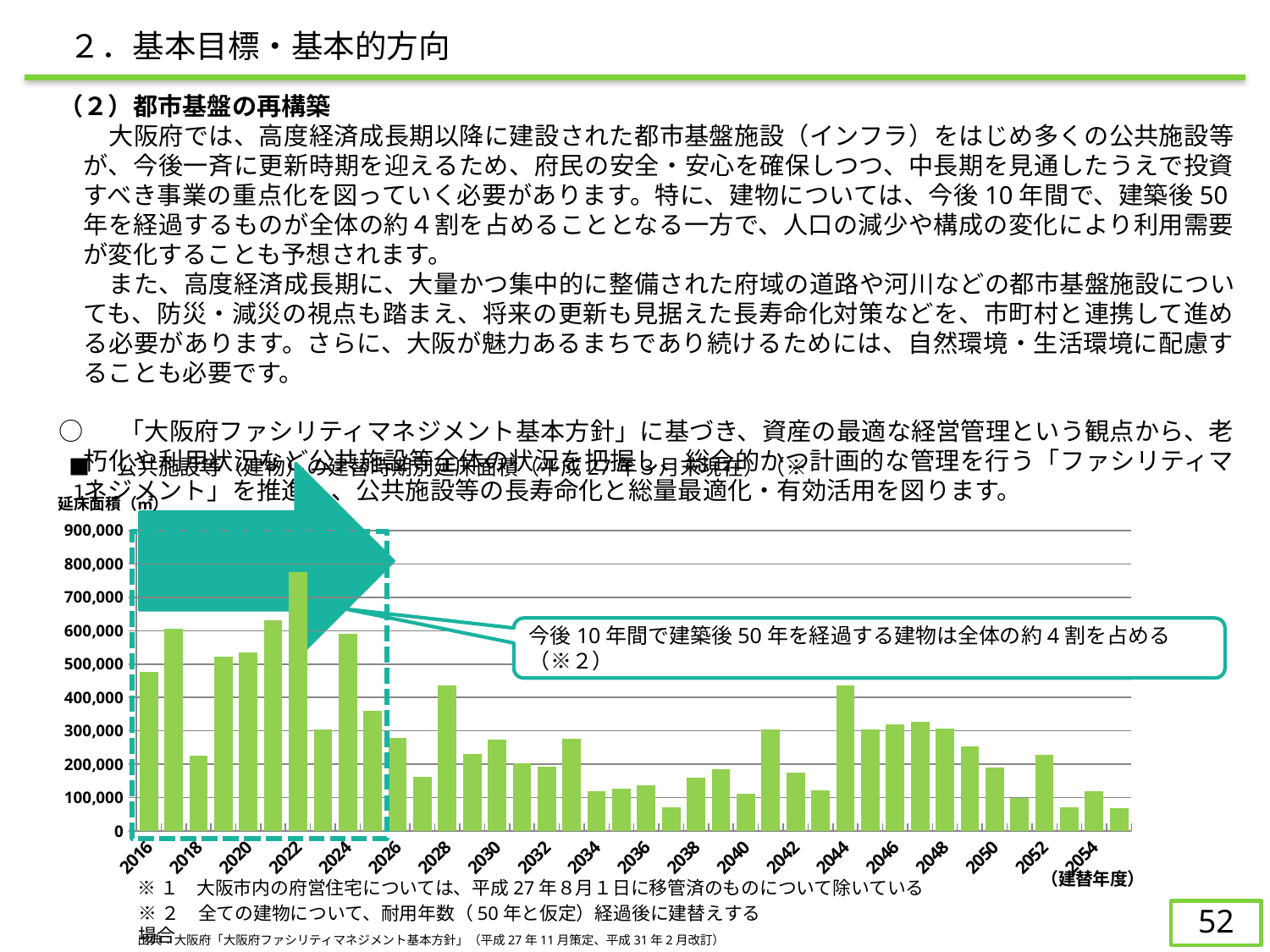
What is the label on the vertical axis of the chart? 延床面積（㎡） Which rebuild year (建替年度) has the highest floor area in the chart? 2022 Is the value for 2022 greater or less than 700,000? greater What kind of chart is shown on the slide? bar chart Do the values rise or fall from 2019 to 2022? rise Which is larger, the value for 2016 or the value for 2017? 2017 Is the value for 2018 greater or less than 300,000? less How many year labels are printed on the x axis of the chart? 20 Is the value for 2044 greater or less than 400,000? greater Which is larger, the value for 2022 or the value for 2024? 2022